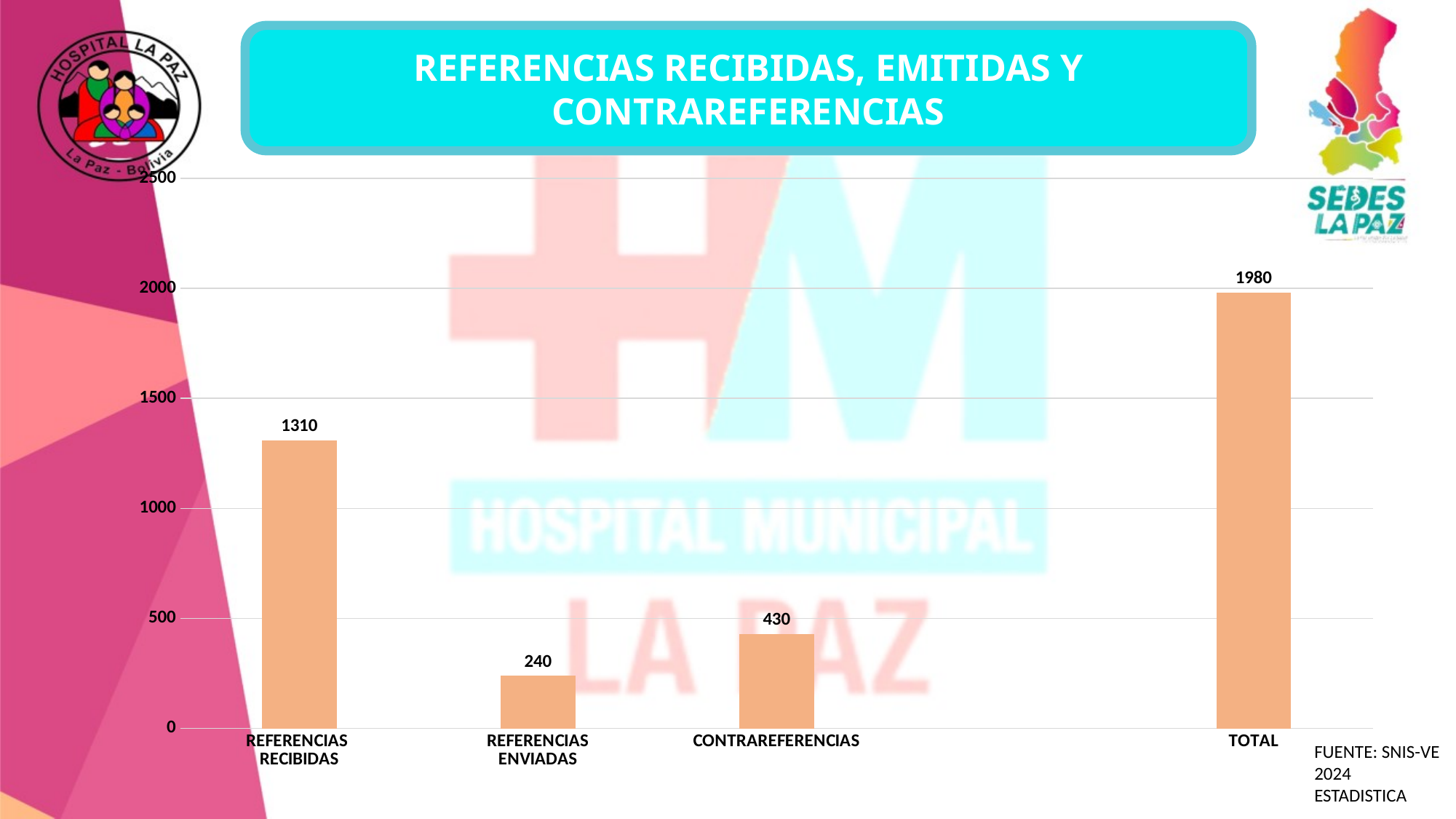
What is the difference between CONTRAREFERENCIAS and REFERENCIAS ENVIADAS? 190 What is the value for REFERENCIAS ENVIADAS? 240 Which is larger, REFERENCIAS RECIBIDAS or CONTRAREFERENCIAS? REFERENCIAS RECIBIDAS Which category has the lowest value? REFERENCIAS ENVIADAS Is the value for CONTRAREFERENCIAS greater or less than 500? less How many categories are shown on the x axis? 4 What is the difference between REFERENCIAS RECIBIDAS and CONTRAREFERENCIAS? 880 What is the value for CONTRAREFERENCIAS? 430 Which category has the highest value? TOTAL What kind of chart is shown on the slide? bar chart What is the value for TOTAL? 1980 What is the value for REFERENCIAS RECIBIDAS? 1310